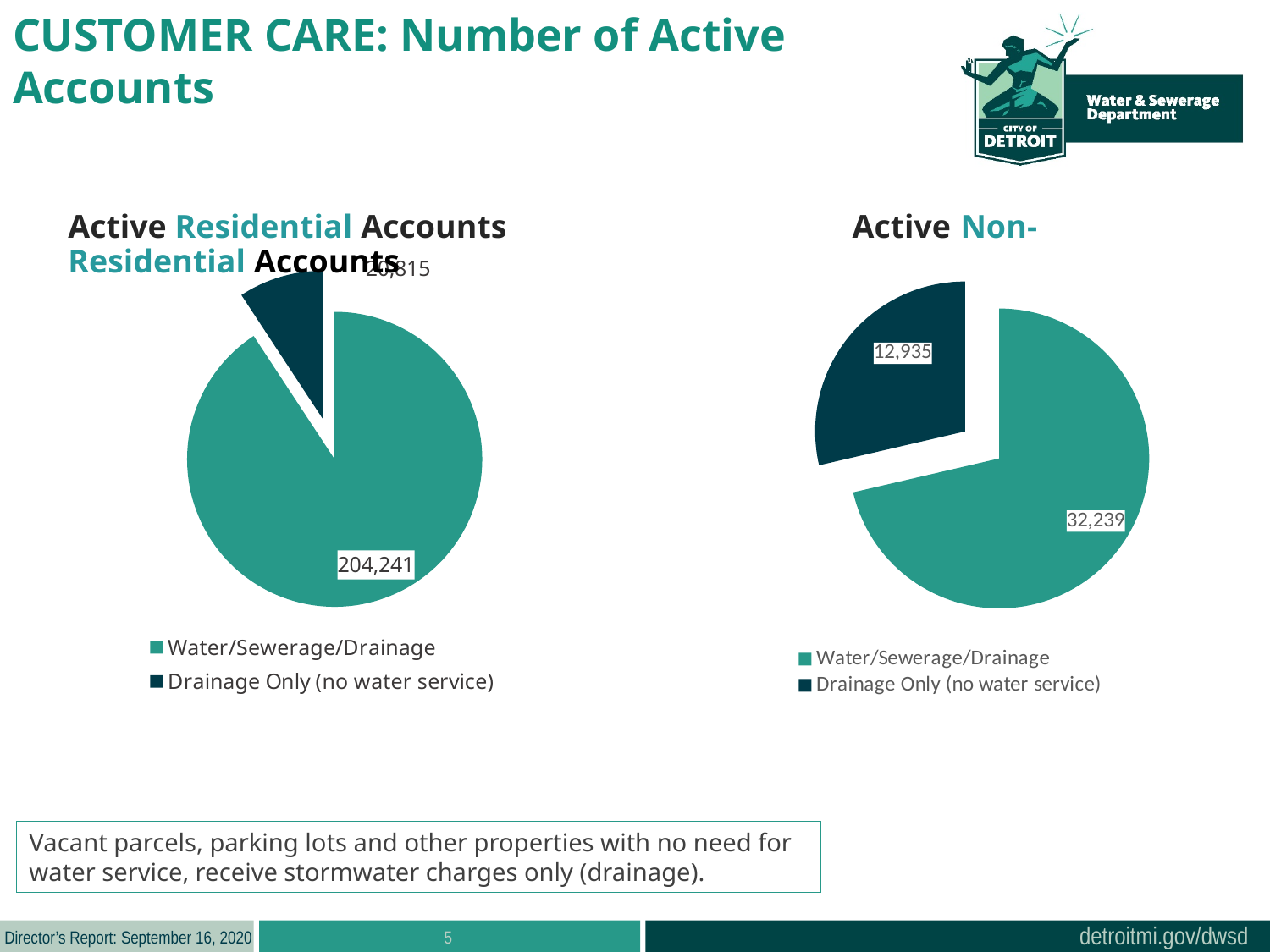
How many entries does the legend of the Active Non-Residential Accounts chart list? 2 How many slices does the Active Residential Accounts pie chart have? 2 In the Active Non-Residential Accounts chart, what is the value for Drainage Only (no water service)? 12,935 In the Active Non-Residential Accounts chart, what is the total of the two slices? 45,174 In the Active Residential Accounts chart, which category has the smallest slice? Drainage Only (no water service) Which is larger: Water/Sewerage/Drainage in the Active Residential Accounts chart or Water/Sewerage/Drainage in the Active Non-Residential Accounts chart? Active Residential Accounts In the Active Residential Accounts chart, what is the value for Water/Sewerage/Drainage? 204,241 In the Active Non-Residential Accounts chart, which legend entry is shown in the dark navy colour? Drainage Only (no water service) What type of chart is the Active Non-Residential Accounts chart? Pie chart In the Active Non-Residential Accounts chart, what is the difference between Water/Sewerage/Drainage and Drainage Only (no water service)? 19,304 In the Active Non-Residential Accounts chart, which category has the largest slice? Water/Sewerage/Drainage In the Active Non-Residential Accounts chart, what is the value for Water/Sewerage/Drainage? 32,239